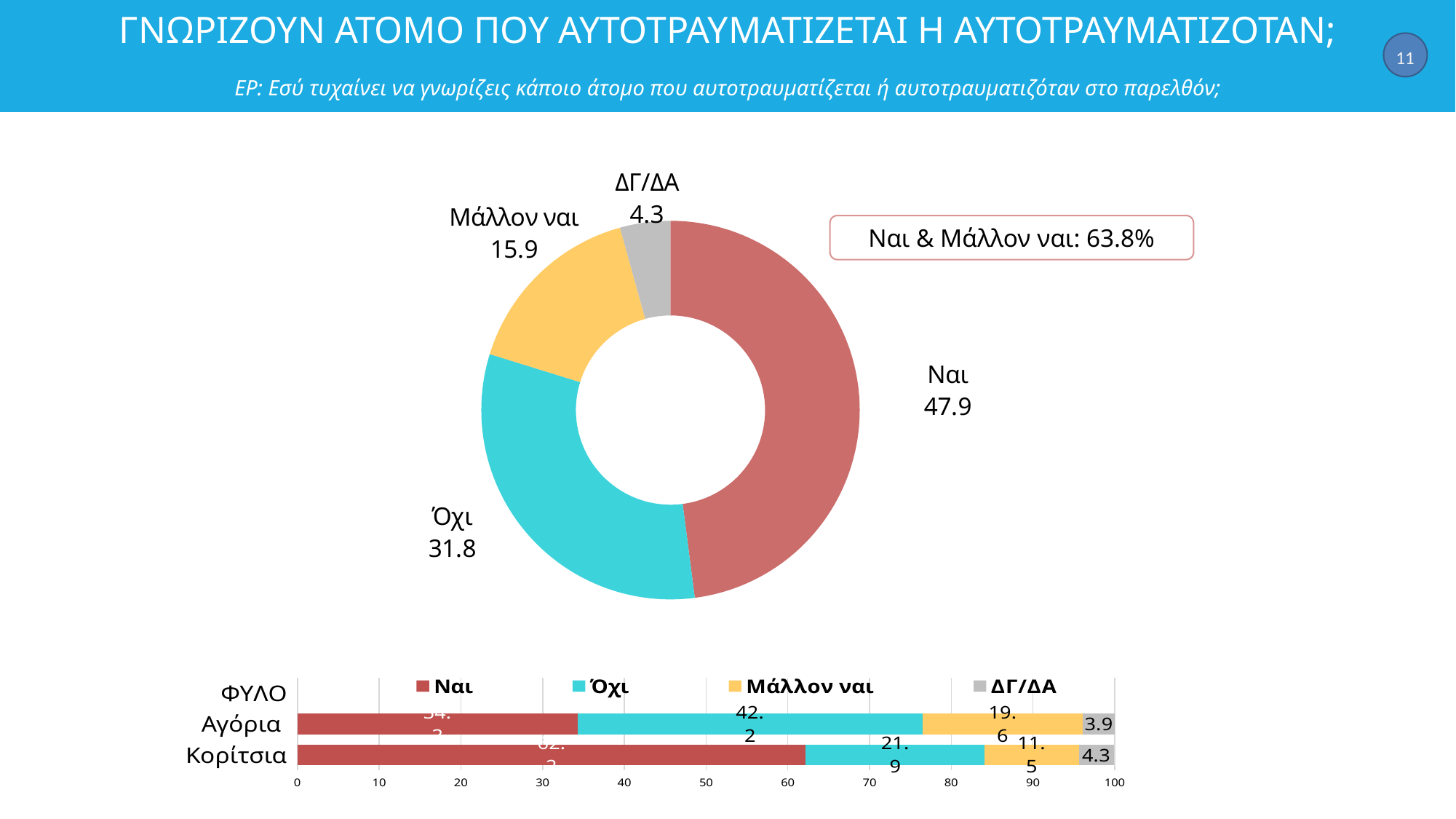
How many series does the legend of the bar chart by ΦΥΛΟ list? 4 In the donut chart, which category has the smallest value? ΔΓ/ΔΑ In the donut chart, what is the difference between the values for Ναι and Όχι? 16.1 In the donut chart, what is the value for Μάλλον ναι? 15.9 In the bar chart by ΦΥΛΟ, what is the value for ΔΓ/ΔΑ for Κορίτσια? 4.3 In the donut chart, which category has the largest value? Ναι In the bar chart by ΦΥΛΟ, what is the value for Όχι for Αγόρια? 42.2 In the bar chart by ΦΥΛΟ, is the Ναι value for Κορίτσια greater or less than 50? greater What type of chart is the upper chart on the slide? Donut (pie) chart In the donut chart, what is the value for Όχι? 31.8 In the donut chart, what is the value for Ναι? 47.9 In the bar chart by ΦΥΛΟ, which group has the larger value for Μάλλον ναι, Αγόρια or Κορίτσια? Αγόρια